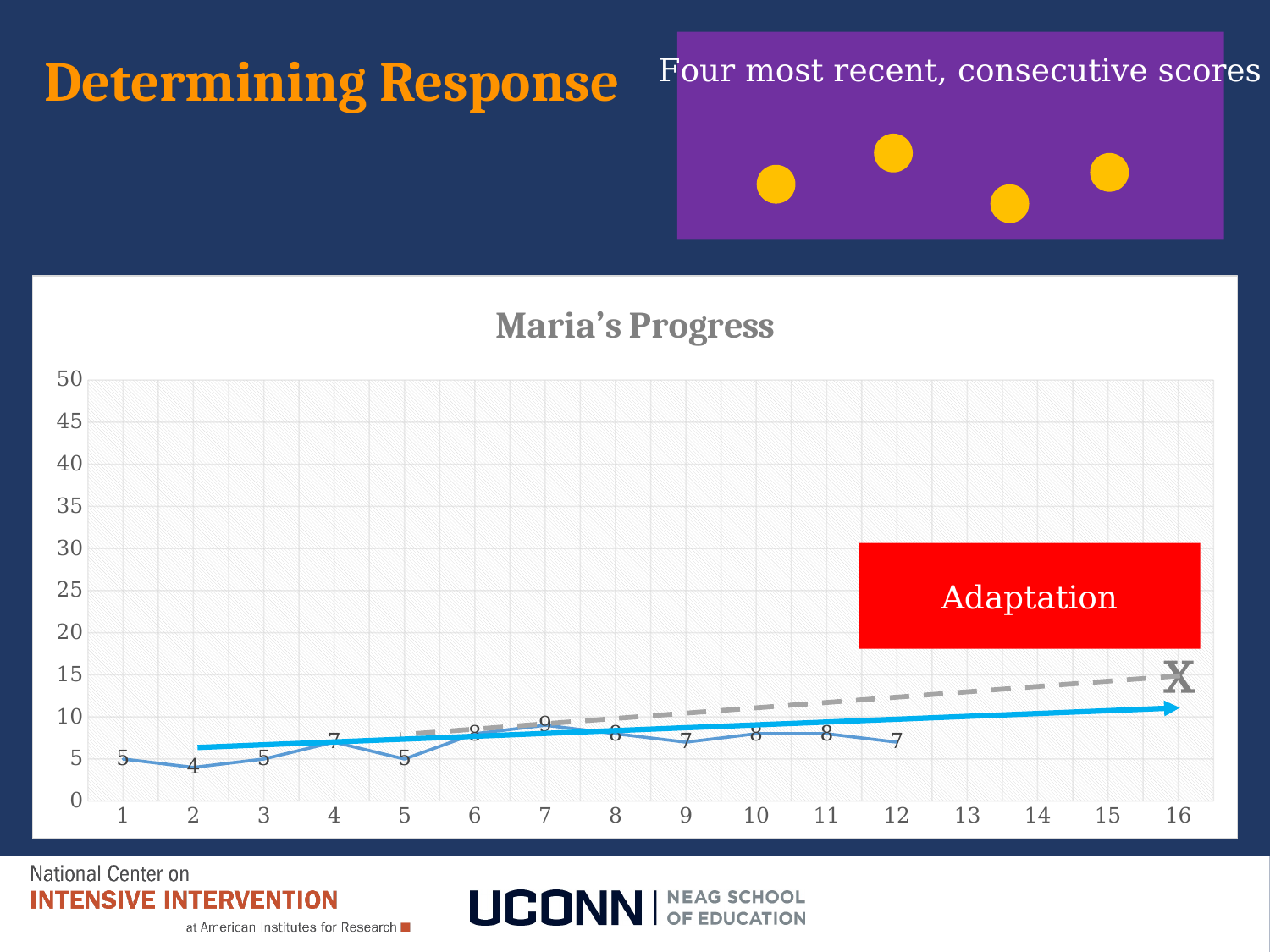
How many data points with scores are plotted on the chart? 12 What is Maria's score at point 12? 7 Is Maria's score at point 10 greater or less than 10? less At which point is Maria's score the highest? 7 What is Maria's score at point 7? 9 At which point is Maria's score the lowest? 2 What is Maria's score at point 1? 5 What is the highest value shown on the y axis? 50 Which is larger, Maria's score at point 4 or her score at point 5? point 4 What kind of chart is shown on the slide? line chart What is the title of the chart? Maria's Progress What is the difference between Maria's score at point 7 and her score at point 2? 5